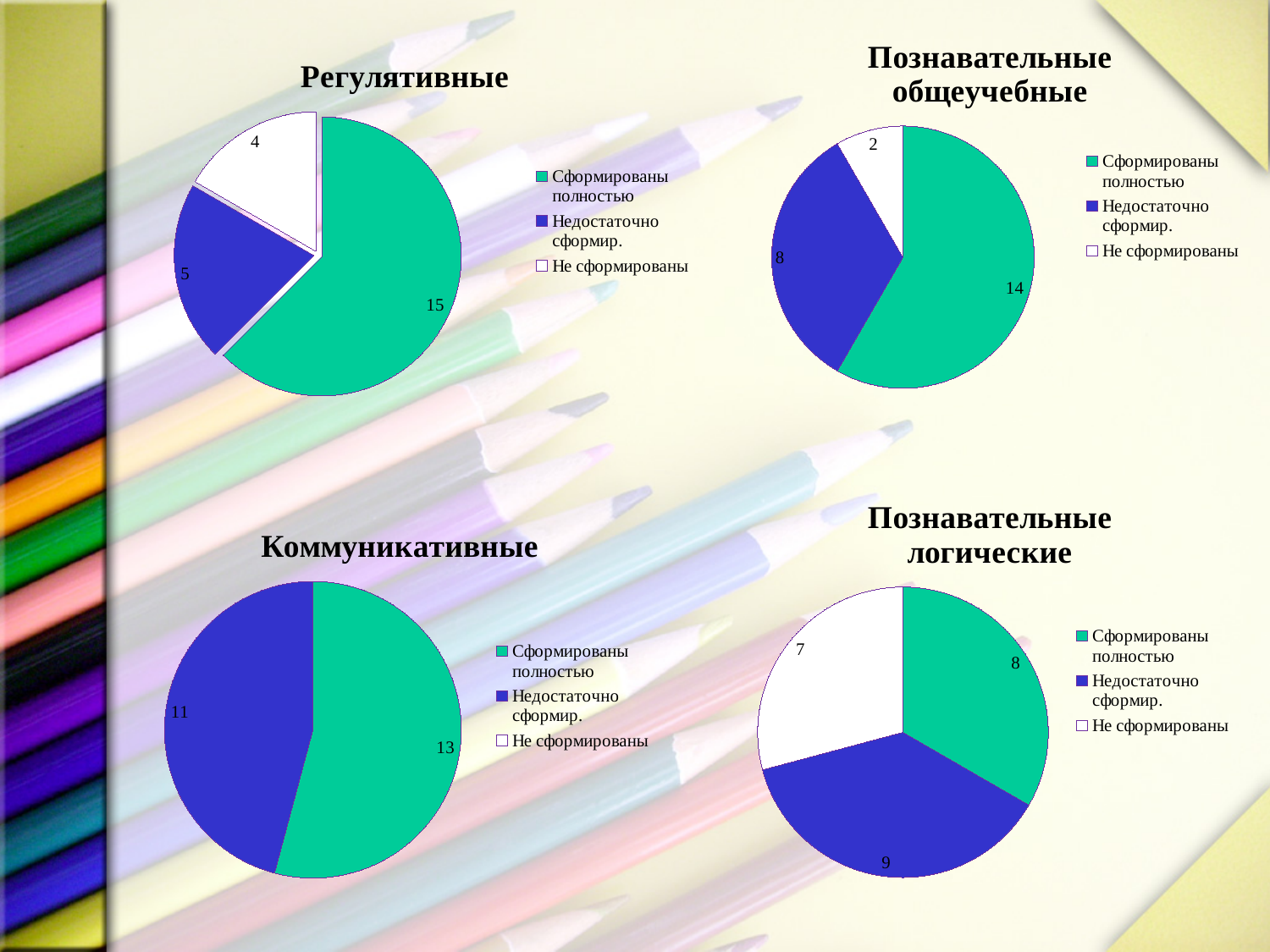
How many pie charts are shown on the slide? 4 In the Регулятивные pie chart, what is the value for Не сформированы? 4 In the Познавательные общеучебные pie chart, what share of the total does Сформированы полностью represent? 58.3% In the Познавательные логические pie chart, what is the value for Не сформированы? 7 In the Коммуникативные pie chart, what is the value for Сформированы полностью? 13 In the Познавательные общеучебные pie chart, what is the value for Недостаточно сформир.? 8 How many entries does the legend of the Регулятивные chart list? 3 In the Регулятивные pie chart, what is the difference between Сформированы полностью and Недостаточно сформир.? 10 In the Коммуникативные pie chart, what is the difference between Сформированы полностью and Недостаточно сформир.? 2 In the Познавательные общеучебные pie chart, which category has the smallest slice? Не сформированы In the Регулятивные pie chart, what is the value for Сформированы полностью? 15 In the Познавательные логические pie chart, which category has the largest slice? Недостаточно сформир.